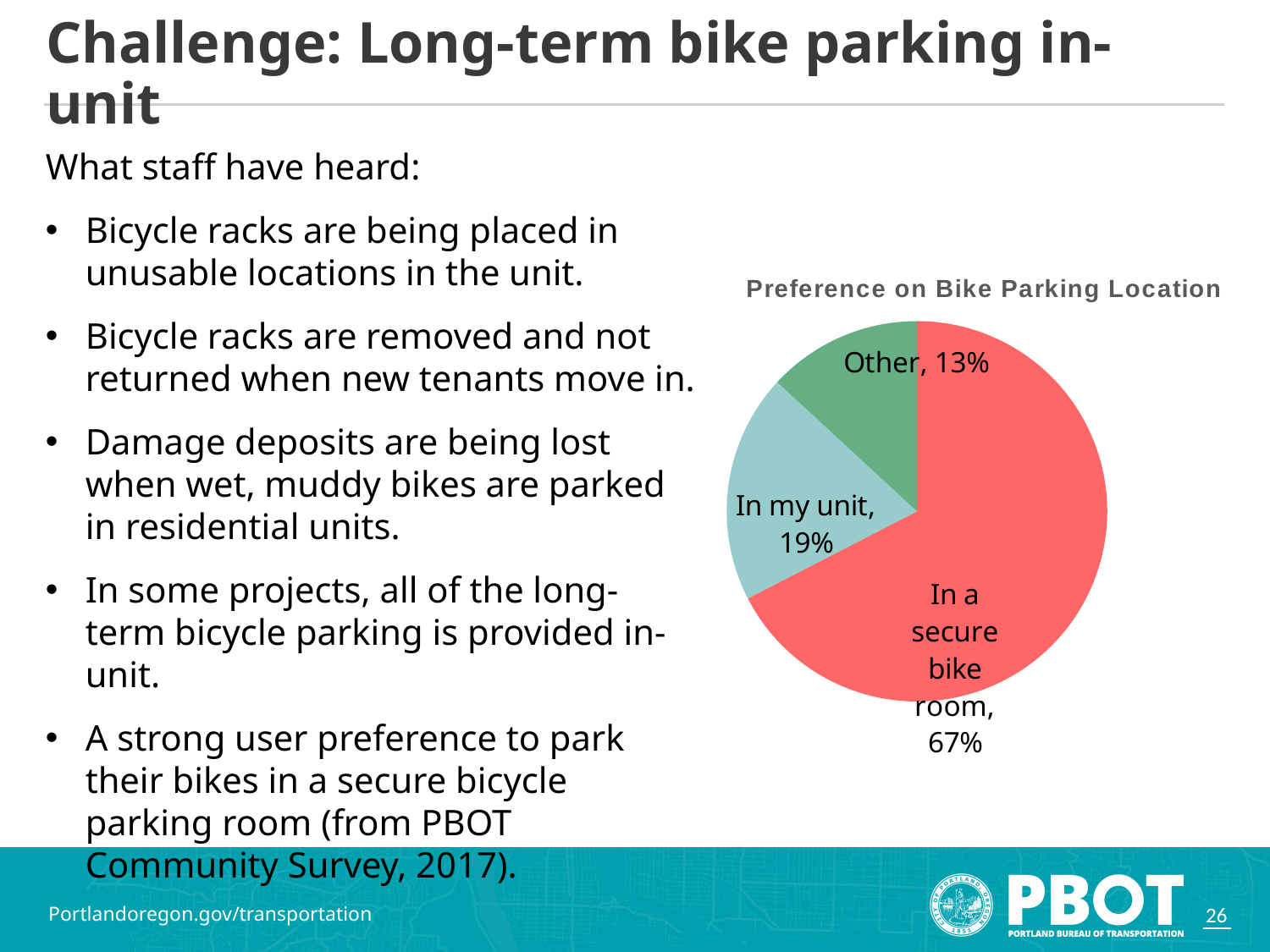
What is the difference in percentage points between 'In my unit' and 'Other'? 6 What colour is the 'In a secure bike room' slice? red What type of chart is shown on the slide? pie chart How many slices does the pie chart have? 3 What percentage of respondents prefer to park in their unit? 19% What is the title of the chart? Preference on Bike Parking Location What is the difference in percentage points between 'In a secure bike room' and 'In my unit'? 48 What percentage of respondents prefer to park in a secure bike room? 67% What percentage is shown for the Other slice? 13% Which is larger, the share for 'In my unit' or the share for 'Other'? In my unit Which bike parking location has the largest share? In a secure bike room Which bike parking location has the smallest share? Other